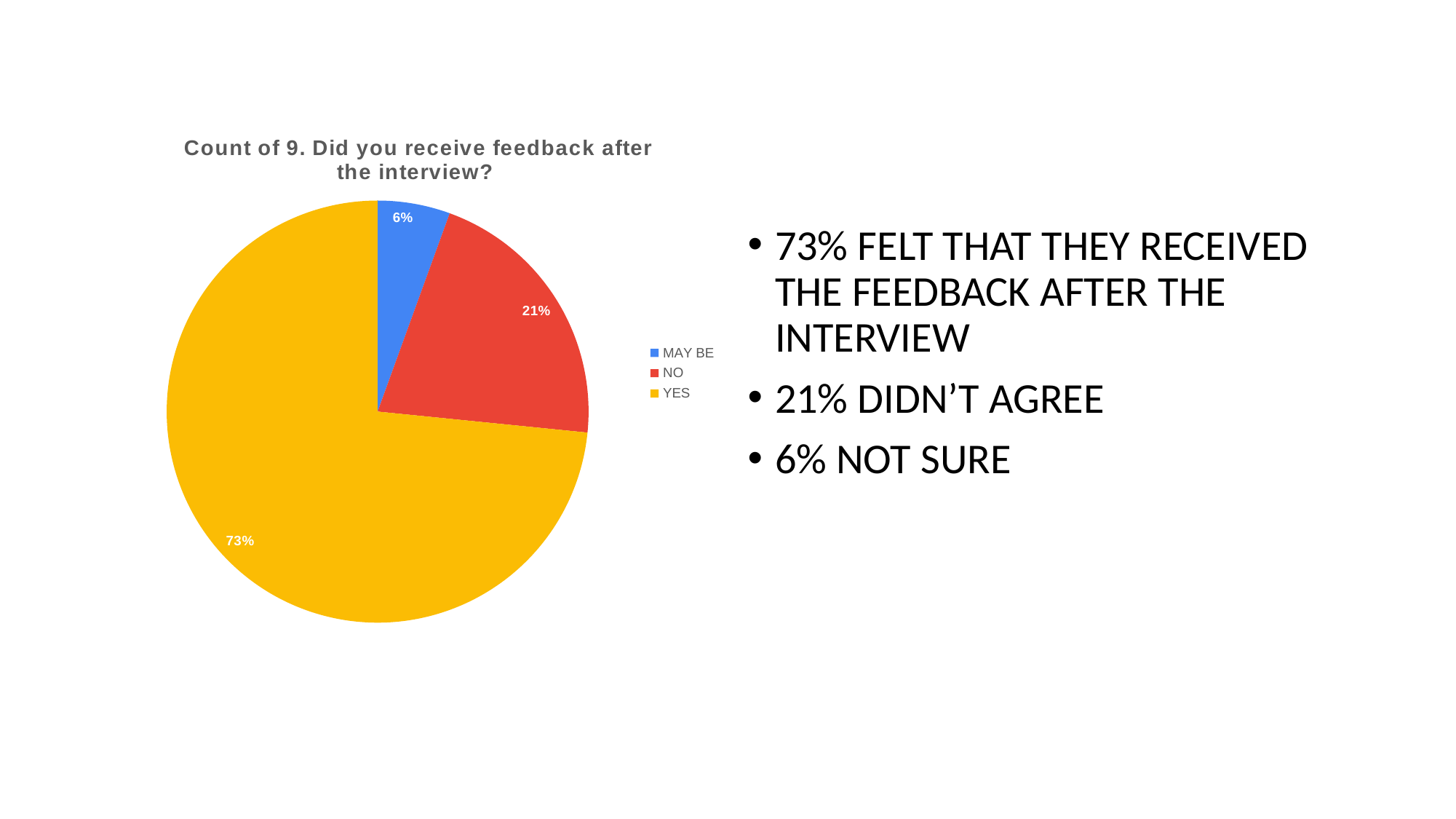
What percentage of the pie is the MAY BE slice? 6% Which category has the smallest share of the pie? MAY BE How many categories does the legend list? 3 What percentage of the pie is the NO slice? 21% What is the title of the chart? Count of 9. Did you receive feedback after the interview? What colour is the YES slice? yellow What type of chart is shown on the slide? pie chart What percentage of the pie is the YES slice? 73% What is the difference in percentage points between the YES and NO slices? 52 Which category has the largest share of the pie? YES Which slice is larger, NO or MAY BE? NO What is the difference in percentage points between the NO and MAY BE slices? 15